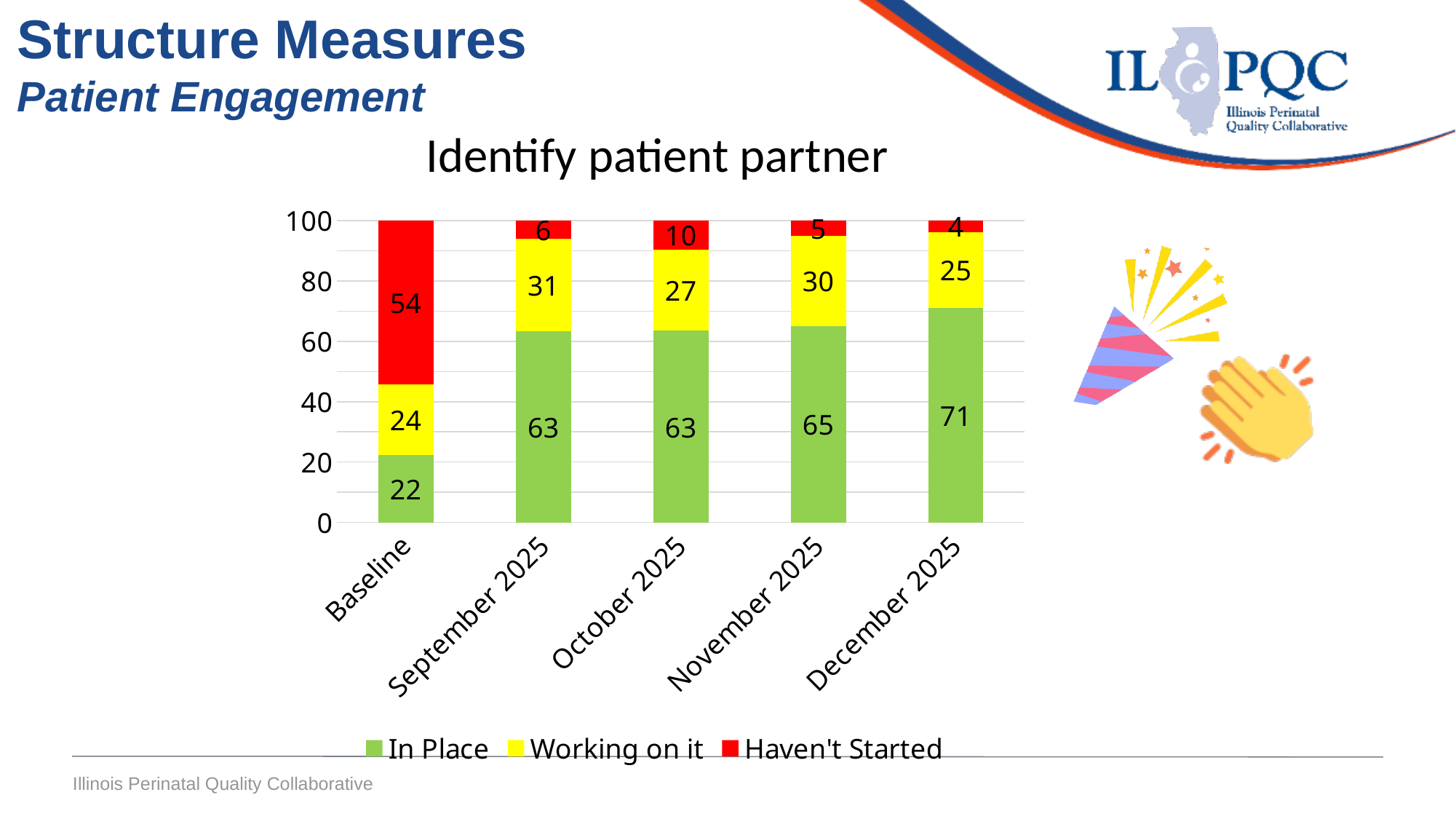
What is the difference between the 'Haven't Started' value at Baseline and at December 2025? 50 What is the 'Haven't Started' value for December 2025? 4 Does the 'In Place' value rise or fall from Baseline to December 2025? Rise How many series does the legend list? 3 How many categories are shown on the x axis? 5 What is the title of the chart? Identify patient partner Which category has the lowest 'In Place' value? Baseline What is the 'In Place' value for Baseline? 22 Which category has the highest 'In Place' value? December 2025 Which is larger, the 'Working on it' value for September 2025 or for November 2025? September 2025 What is the 'Working on it' value for October 2025? 27 What kind of chart is shown? Stacked bar chart